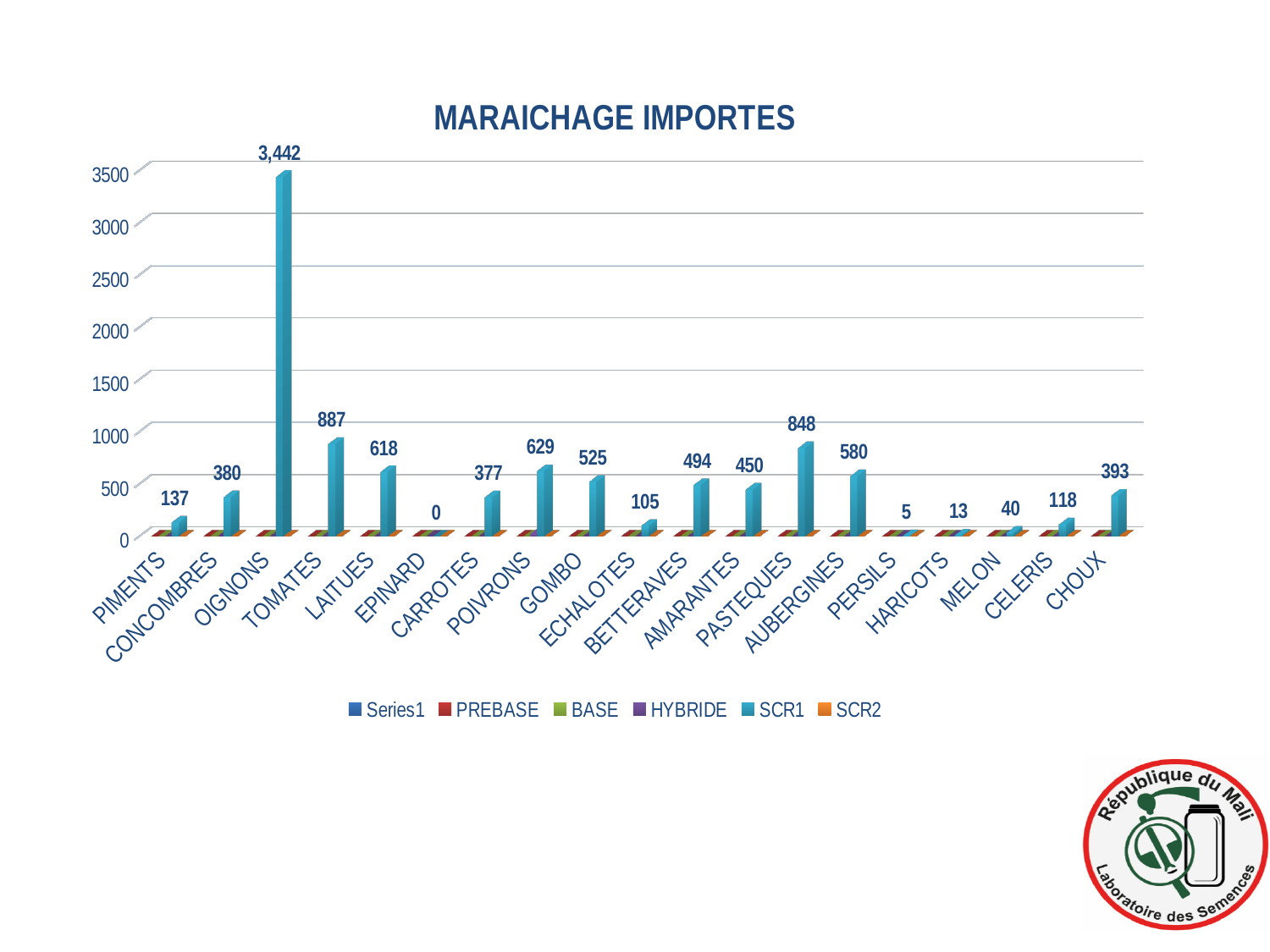
What is the SCR1 value for OIGNONS? 3,442 How many series does the legend list? 6 How many categories are shown on the x axis? 19 Which category has the highest SCR1 value? OIGNONS What kind of chart is shown on the slide? Bar chart What is the title of the chart? MARAICHAGE IMPORTES Which category has the lowest SCR1 value? EPINARD What is the SCR1 value for CHOUX? 393 What is the SCR1 value for TOMATES? 887 Which has a larger SCR1 value, LAITUES or POIVRONS? POIVRONS What is the SCR1 value for ECHALOTES? 105 What is the difference between the SCR1 values for PASTEQUES and AUBERGINES? 268